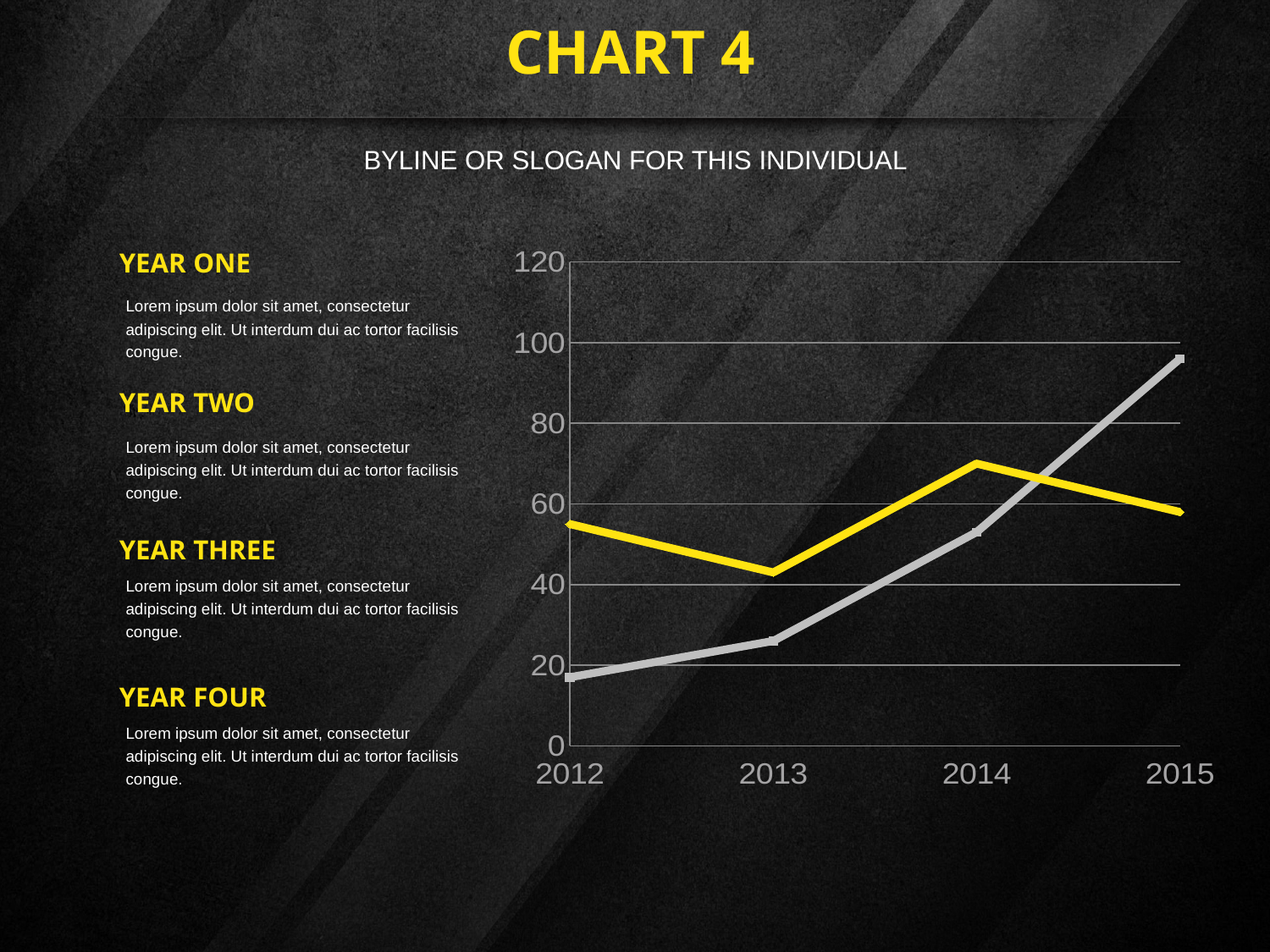
How many years are shown on the x axis of the chart? 4 Does the gray line rise or fall from 2012 to 2015? rise In which year does the gray line reach its highest value? 2015 Is the value of the yellow line in 2014 greater or less than 60? greater In 2012, which line has the higher value, the yellow line or the gray line? the yellow line In 2015, which line has the higher value, the yellow line or the gray line? the gray line Is the value of the gray line in 2014 greater or less than 40? greater What kind of chart is shown on the slide? line chart In which year does the yellow line reach its lowest value? 2013 Is the value of the gray line in 2012 greater or less than 20? less How many lines are plotted on the chart? 2